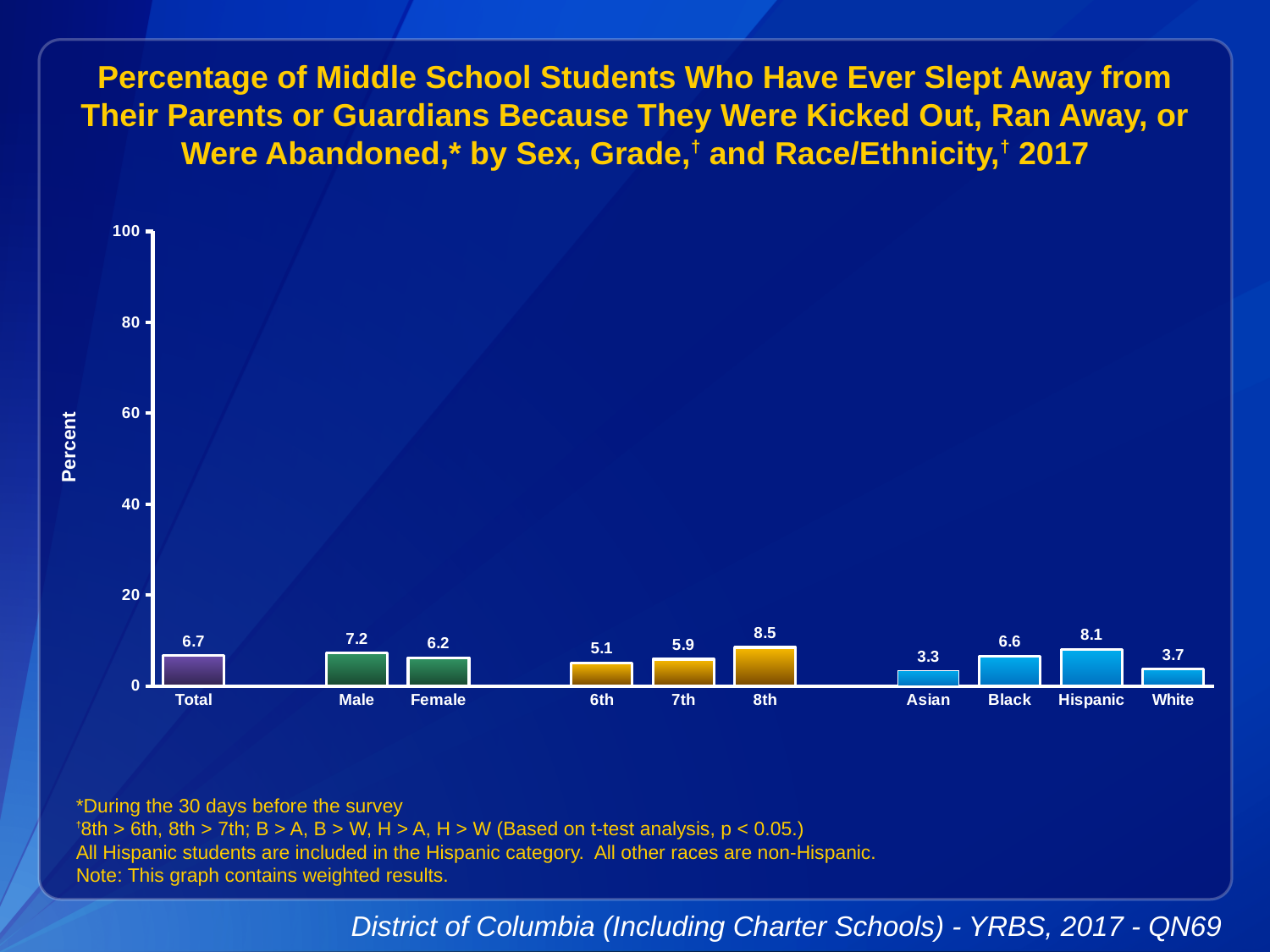
What kind of chart is this? bar chart Do the values rise or fall from 6th grade to 8th grade? rise Which is larger, the value for Black or the value for White? Black Which category has the lowest value? Asian What is the value for Hispanic students? 8.1 What is the value for Total? 6.7 What is the difference between the Male and Female values? 1.0 Is the value for 8th grade greater or less than 20? less How many categories are shown on the x axis? 10 What is the value for 6th grade? 5.1 What is the label on the y axis? Percent Which category has the highest value? 8th